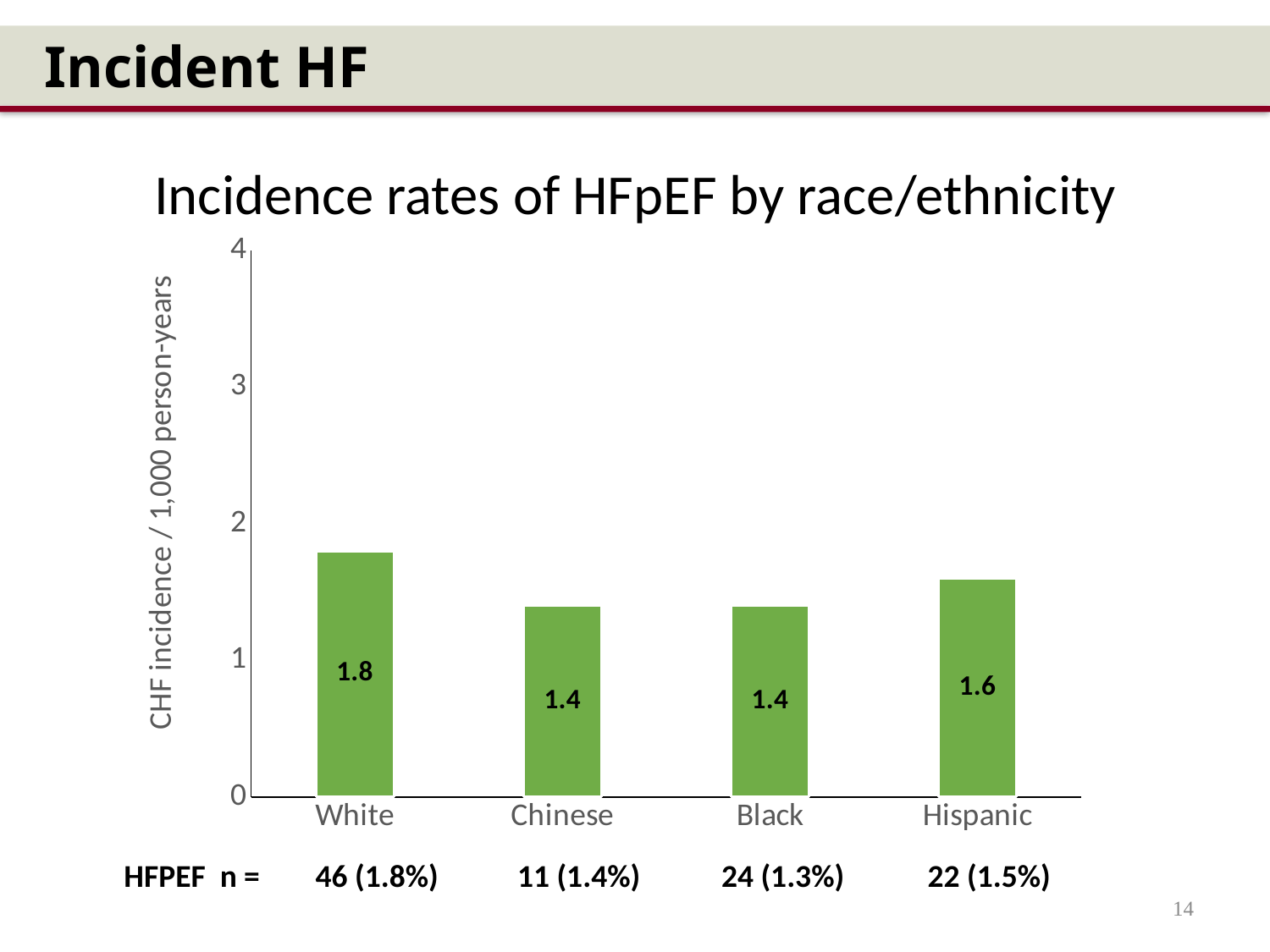
How many race/ethnicity categories are shown on the chart? 4 Which has a higher incidence rate, Hispanic or Chinese? Hispanic What kind of chart is shown on the slide? Bar chart What is the title of the chart? Incidence rates of HFpEF by race/ethnicity What is the CHF incidence rate for Hispanic participants? 1.6 What is the CHF incidence rate for Chinese participants? 1.4 What is the difference between the incidence rates for Hispanic and Chinese participants? 0.2 Which race/ethnicity group has the highest HFpEF incidence rate? White What is the difference between the incidence rates for White and Black participants? 0.4 What is the CHF incidence rate for White participants? 1.8 What is the label of the y-axis? CHF incidence / 1,000 person-years Is the value for White greater or less than 2? less